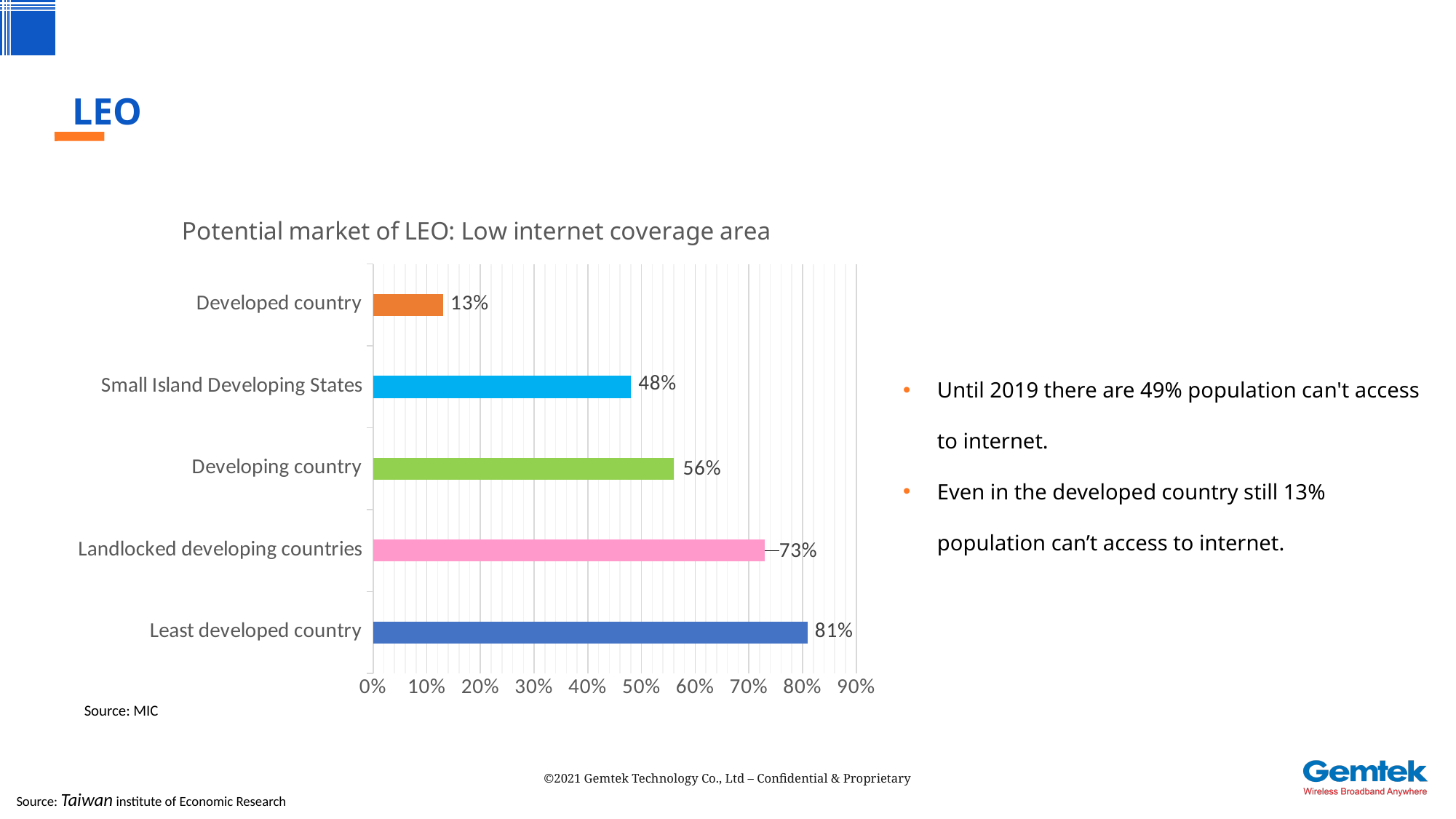
What is the value for Small Island Developing States? 48% Which category has the lowest value? Developed country How many categories are shown in the chart? 5 What is the value for Developed country? 13% What kind of chart is shown on the slide? bar chart What colour is the bar for Developing country? green What is the value for Landlocked developing countries? 73% Is the value for Landlocked developing countries greater or less than 70%? greater What is the title of the chart? Potential market of LEO: Low internet coverage area Which category has the highest value? Least developed country What is the difference between the values for Least developed country and Developing country? 25% Which is larger, the value for Developing country or the value for Small Island Developing States? Developing country